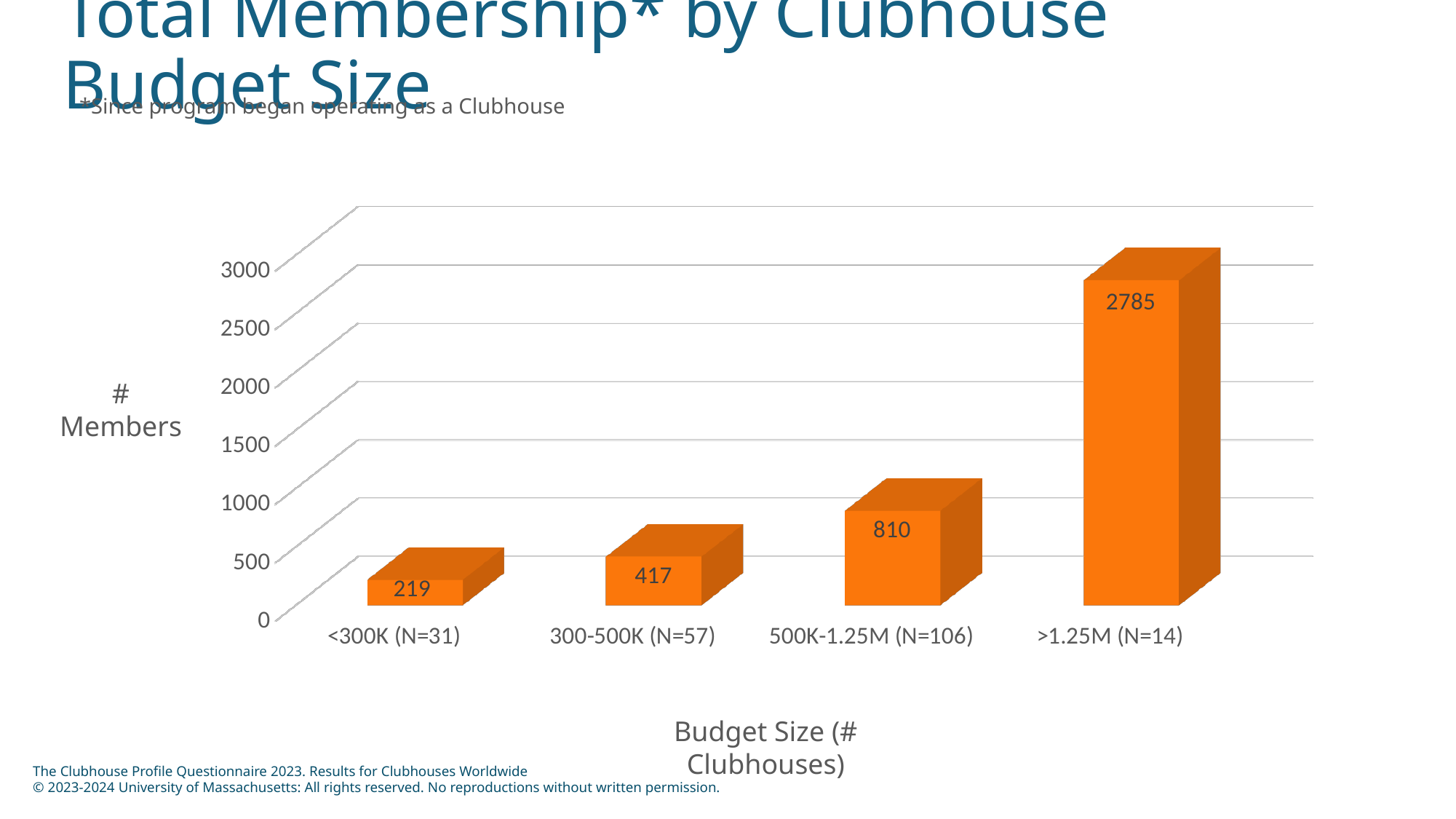
What is the total membership for clubhouses with a budget size of 500K-1.25M (N=106)? 810 What is the total membership for clubhouses with a budget size of <300K (N=31)? 219 Which budget size category has the lowest total membership? <300K (N=31) Which has a larger total membership: the 300-500K category or the 500K-1.25M category? 500K-1.25M What is the total membership for clubhouses with a budget size of 300-500K (N=57)? 417 What is the total membership for clubhouses with a budget size of >1.25M (N=14)? 2785 What is the difference in total membership between the >1.25M and 500K-1.25M budget categories? 1975 What is the difference in total membership between the 300-500K and <300K budget categories? 198 How many budget size categories are shown in the chart? 4 Do the membership values rise or fall as budget size increases along the x axis? Rise Which budget size category has the highest total membership? >1.25M (N=14) What kind of chart is shown on the slide? Bar chart